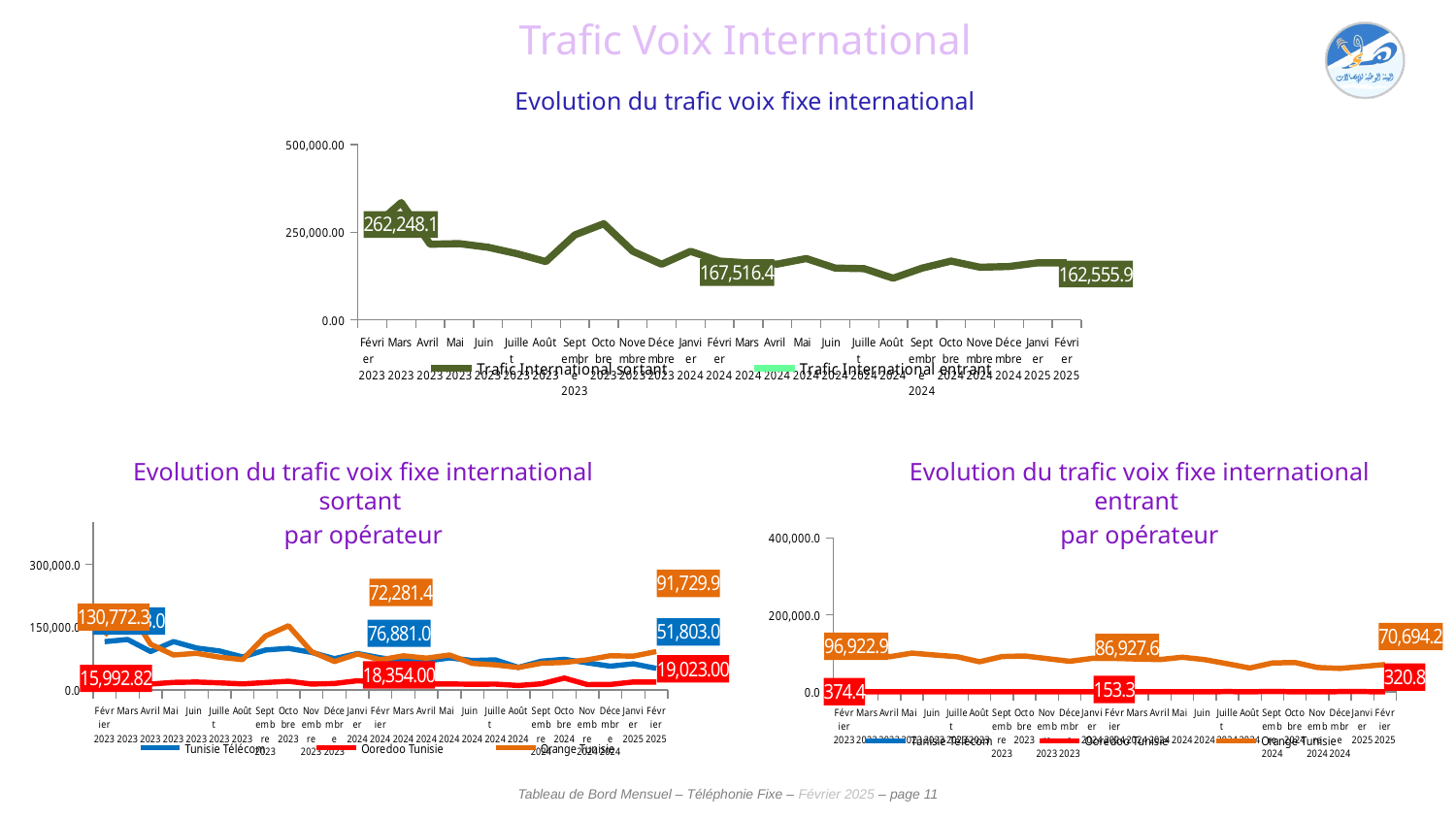
In the bottom-right chart 'Evolution du trafic voix fixe international entrant par opérateur', which is larger in Janvier 2024: Orange Tunisie or Ooredoo Tunisie? Orange Tunisie In the top chart 'Evolution du trafic voix fixe international', what value is labelled at Février 2025? 162,555.9 How many series does the legend of the bottom-left chart 'Evolution du trafic voix fixe international sortant par opérateur' list? 3 In the bottom-left chart 'Evolution du trafic voix fixe international sortant par opérateur', what is the labelled value for Orange Tunisie in Février 2025? 91,729.9 In the bottom-right chart 'Evolution du trafic voix fixe international entrant par opérateur', what is the labelled value for Orange Tunisie in Février 2023? 96,922.9 In the top chart 'Evolution du trafic voix fixe international', does the plotted line overall rise or fall from Février 2023 to Février 2025? fall In the top chart 'Evolution du trafic voix fixe international', what is the difference between the labelled value for Février 2023 (262,248.1) and the labelled value for Février 2025 (162,555.9)? 99,692.2 How many series does the legend of the top chart 'Evolution du trafic voix fixe international' list? 2 What kind of chart is the top chart titled 'Evolution du trafic voix fixe international'? line chart In the bottom-left chart 'Evolution du trafic voix fixe international sortant par opérateur', which operator has the highest value in Février 2025? Orange Tunisie In the bottom-left chart 'Evolution du trafic voix fixe international sortant par opérateur', what is the difference between Orange Tunisie (91,729.9) and Tunisie Télécom (51,803.0) in Février 2025? 39,926.9